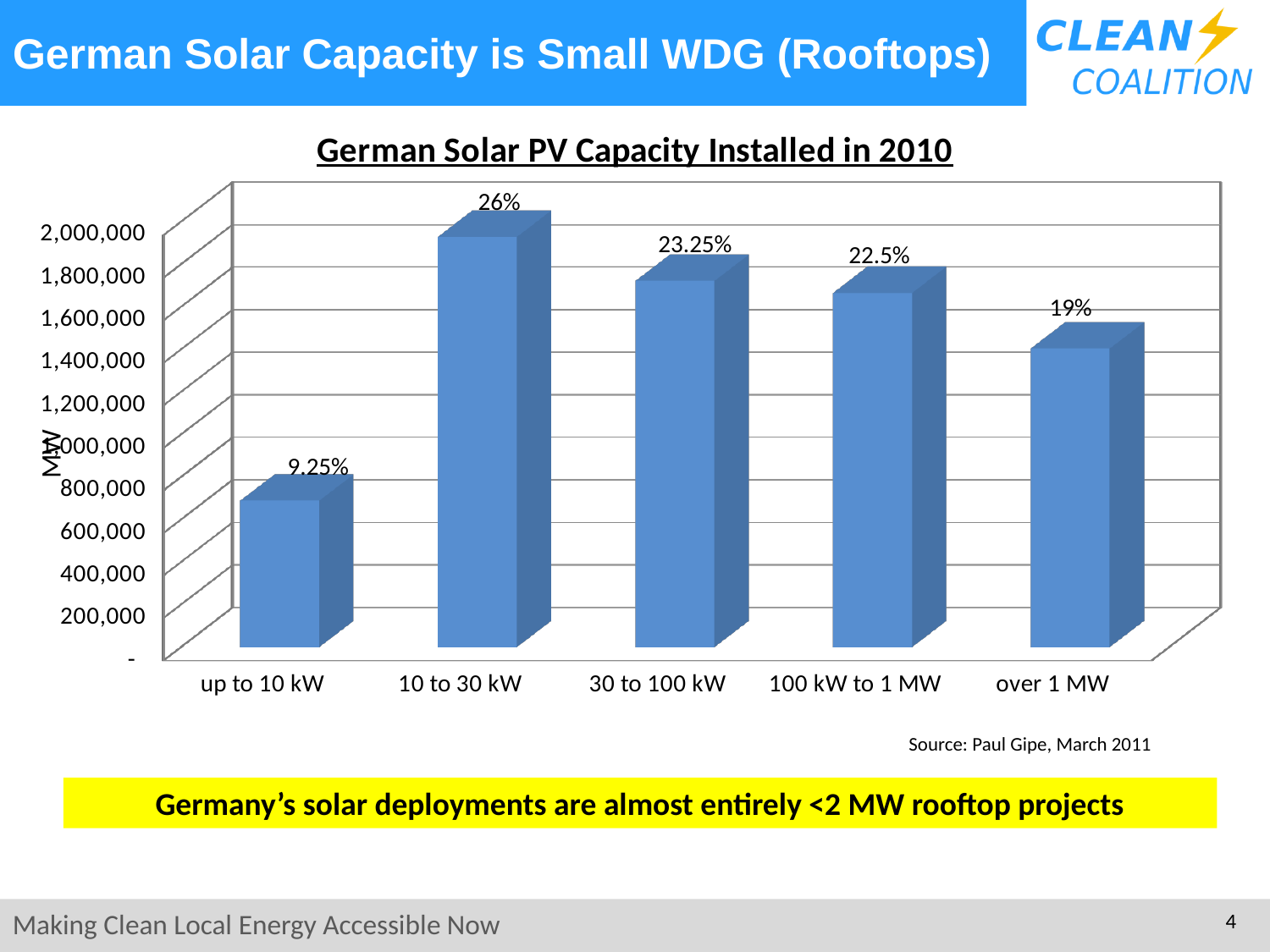
What is the difference in percentage points between the labels for '10 to 30 kW' and 'up to 10 kW'? 16.75% Which bar is taller: '100 kW to 1 MW' or 'over 1 MW'? 100 kW to 1 MW What percentage label is shown on the bar for '30 to 100 kW'? 23.25% Is the value for '10 to 30 kW' greater or less than 1,600,000? greater What is the title of the chart? German Solar PV Capacity Installed in 2010 Which category has the lowest bar? up to 10 kW What percentage label is shown on the bar for 'over 1 MW'? 19% How many categories are shown on the x axis? 5 Is the value for 'up to 10 kW' greater or less than 1,000,000? less Which category has the highest bar? 10 to 30 kW What percentage label is shown on the bar for '10 to 30 kW'? 26% What percentage label is shown on the bar for 'up to 10 kW'? 9.25%